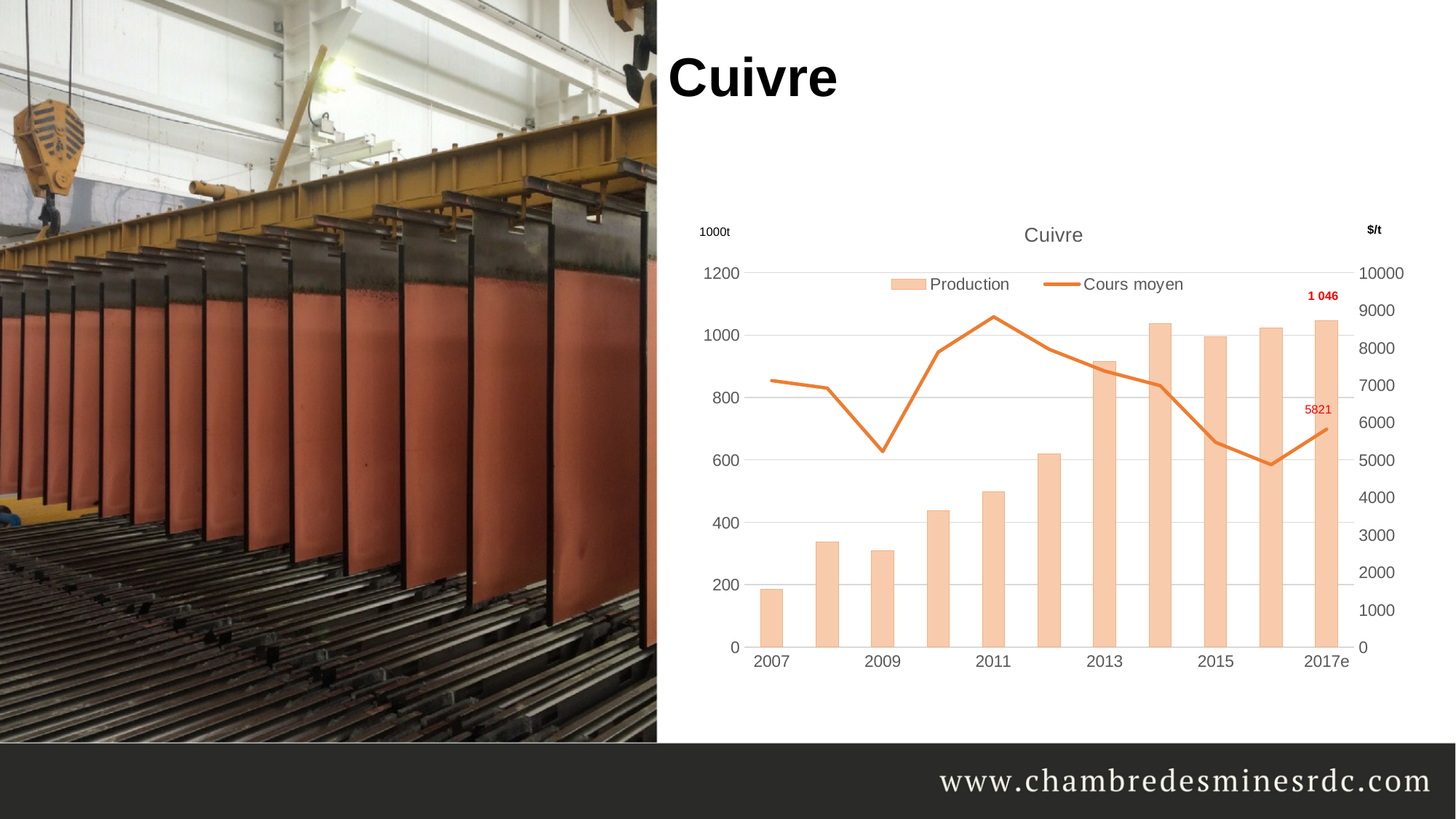
Which year has the lowest Production? 2007 Is the Cours moyen value for 2011 greater or less than 8000? greater What is the Cours moyen value for 2017e? 5821 How many series does the legend list? 2 Does the Cours moyen rise or fall from 2011 to 2016? fall What unit is shown on the left axis? 1000t Which year has the highest Cours moyen? 2011 What kind of chart is shown? Combined bar and line chart Which is larger, the Production for 2012 or for 2013? 2013 Is the Production value for 2009 greater or less than 400? less What is the Production value for 2017e? 1 046